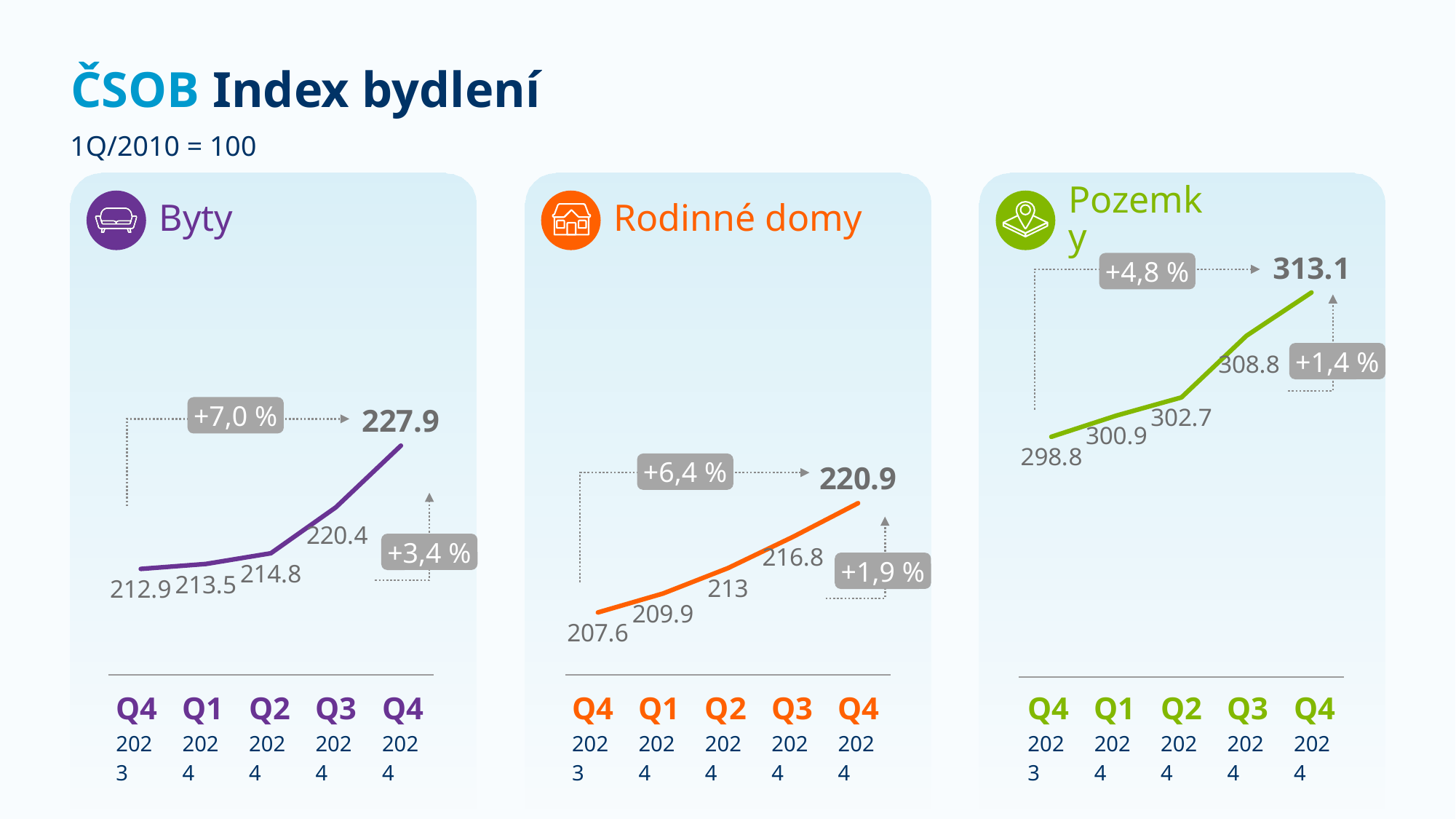
In the Pozemky chart, what is the index value for Q2 2024? 302.7 In the Pozemky chart, which is larger, the value for Q3 2024 or Q1 2024? Q3 2024 What percentage change is shown between Q4 2023 and Q4 2024 in the Pozemky chart? +4,8 % In the Byty chart, which quarter has the lowest index value? Q4 2023 How many quarters are plotted in the Rodinné domy chart? 5 In the Byty chart, what is the index value for Q4 2024? 227.9 In the Pozemky chart, which quarter has the highest index value? Q4 2024 What kind of chart is used in the Byty panel? line chart In the Rodinné domy chart, what is the index value for Q4 2023? 207.6 In the Byty chart, what is the difference between the Q4 2024 and Q4 2023 values? 15 In the Rodinné domy chart, what is the difference between the Q4 2024 and Q3 2024 values? 4.1 In the Rodinné domy chart, do the values rise or fall from Q4 2023 to Q4 2024? rise